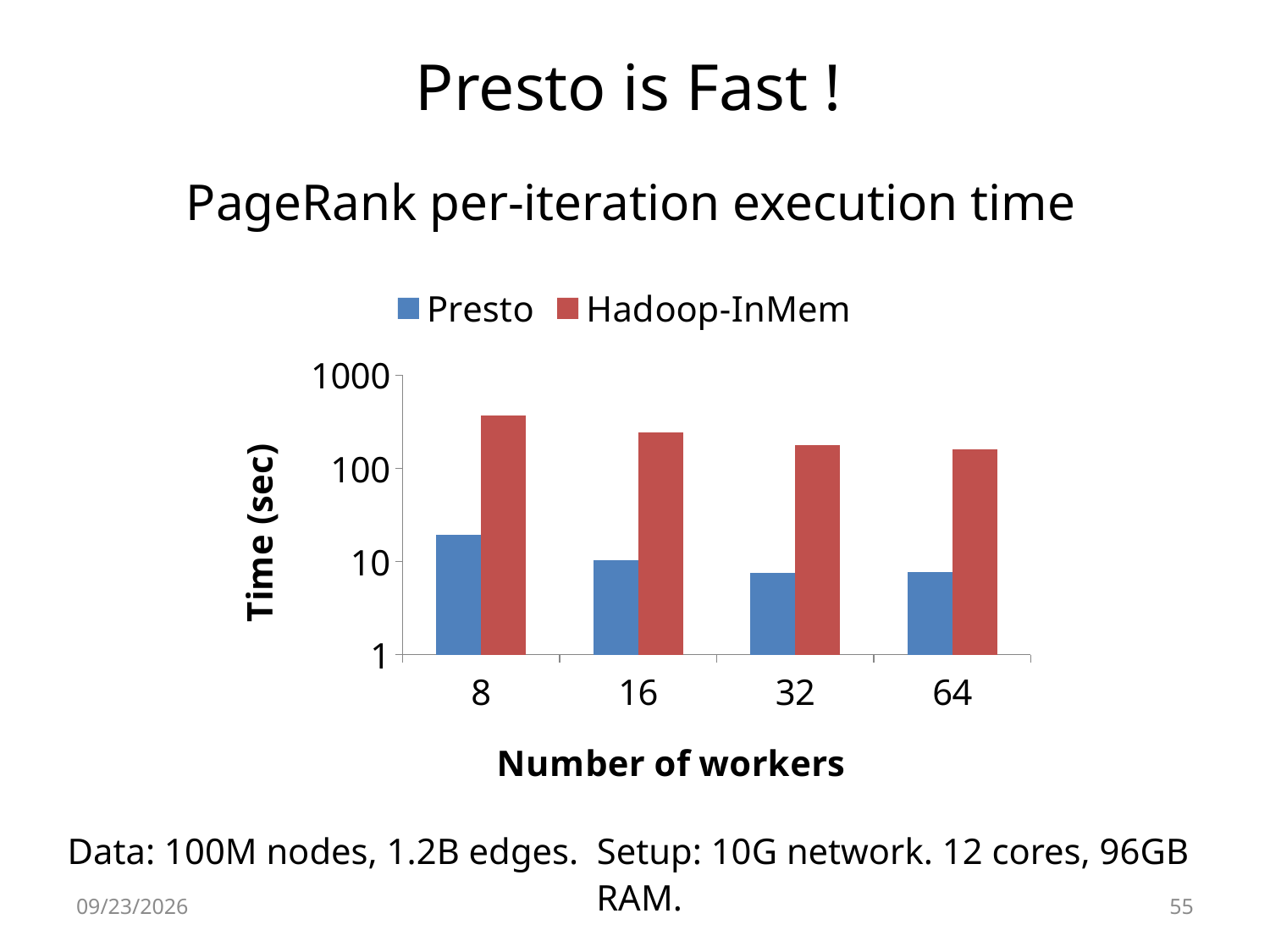
How many series does the legend list? 2 Does the Hadoop-InMem execution time rise or fall as the number of workers increases? fall Is the Presto value for 8 workers greater or less than 10? greater What is the label of the y axis? Time (sec) How many worker counts are shown on the x axis? 4 At which number of workers is the Presto execution time highest? 8 Is the Hadoop-InMem value for 64 workers greater or less than 1000? less At which number of workers is the Hadoop-InMem execution time highest? 8 Which series has the higher execution time at 32 workers, Presto or Hadoop-InMem? Hadoop-InMem Is the Hadoop-InMem value for 8 workers greater or less than 100? greater What kind of chart is shown on the slide? bar chart